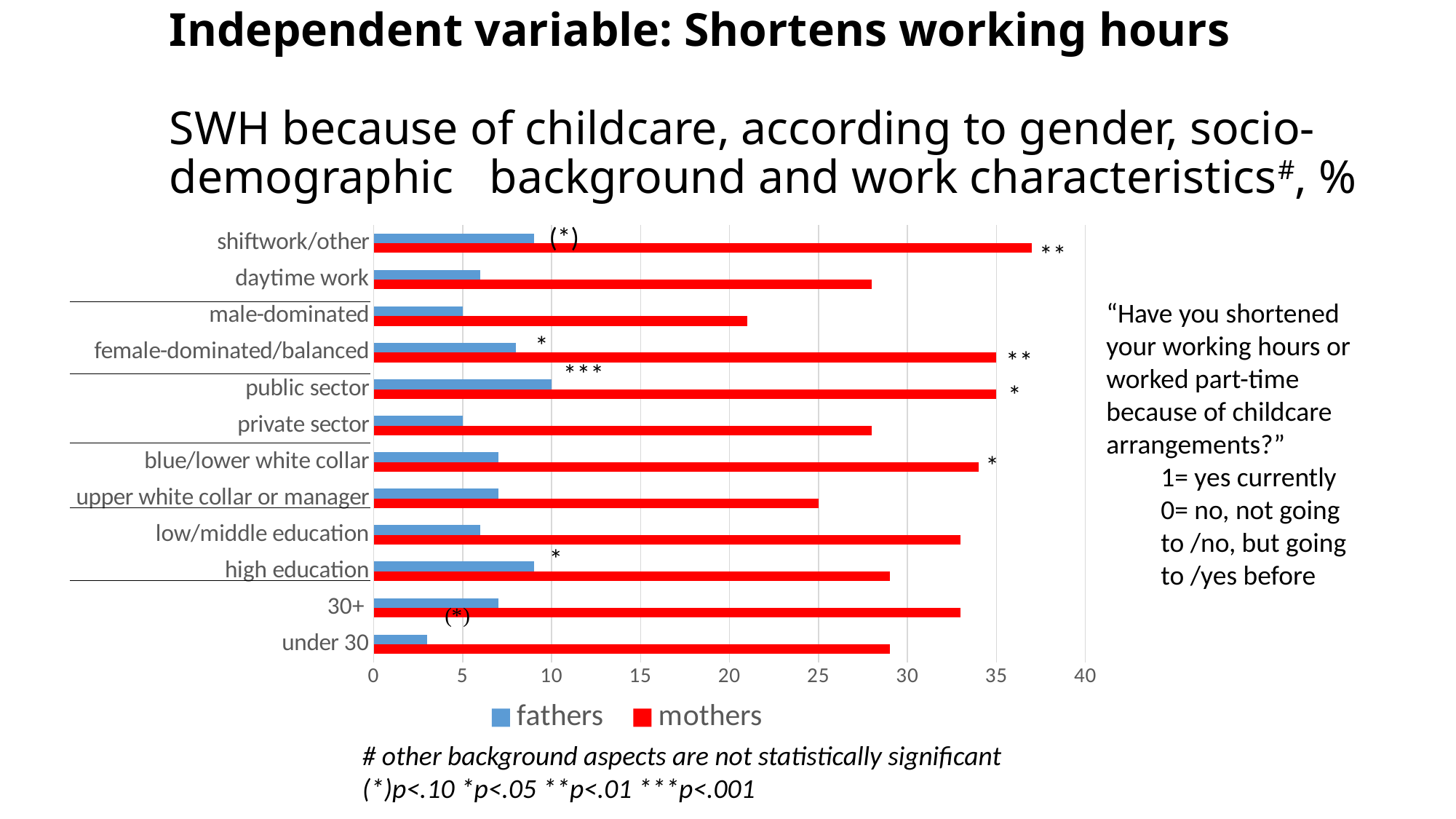
Which category has the lowest value for mothers? male-dominated Which is larger for mothers: daytime work or shiftwork/other? shiftwork/other Is the value for mothers in shiftwork/other greater or less than 35? greater Which is larger for fathers: high education or under 30? high education Which category has the highest value for mothers? shiftwork/other How many series does the legend list? 2 Is the value for mothers in male-dominated greater or less than 25? less Which category has the lowest value for fathers? under 30 How many categories are plotted on the chart? 12 What colour are the bars for mothers? red Is the value for fathers under 30 greater or less than 5? less What kind of chart is shown on the slide? bar chart